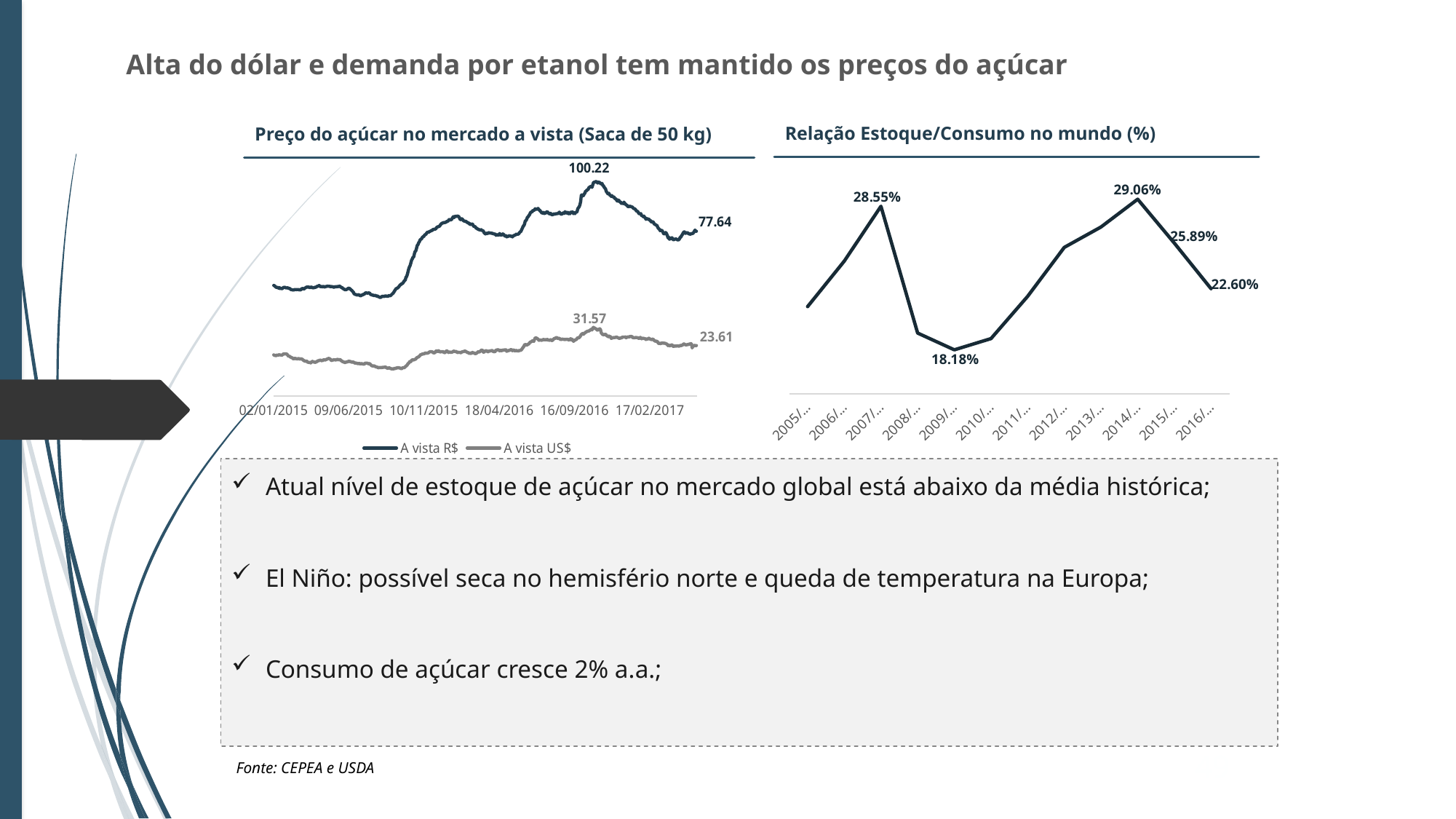
What kind of chart is the left chart, 'Preço do açúcar no mercado a vista (Saca de 50 kg)'? Line chart In the right chart, 'Relação Estoque/Consumo no mundo (%)', what is the lowest labeled value? 18.18% In the left chart, 'Preço do açúcar no mercado a vista', what is the difference between the peak value (100.22) and the final value (77.64) of the 'A vista R$' line? 22.58 In the left chart, 'Preço do açúcar no mercado a vista', what is the final value labeled at the end of the 'A vista US$' line? 23.61 In the right chart, 'Relação Estoque/Consumo no mundo (%)', do the values rise or fall over the last three labeled points (29.06%, 25.89%, 22.60%)? Fall How many seasons (x-axis categories) are shown in the right chart, 'Relação Estoque/Consumo no mundo (%)'? 12 In the left chart, 'Preço do açúcar no mercado a vista', what is the peak value labeled on the 'A vista R$' line? 100.22 In the left chart, 'Preço do açúcar no mercado a vista', what is the peak value labeled on the 'A vista US$' line? 31.57 In the left chart, 'Preço do açúcar no mercado a vista', what is the final value labeled at the end of the 'A vista R$' line? 77.64 What are the two legend entries of the left chart, 'Preço do açúcar no mercado a vista'? A vista R$ and A vista US$ How many series does the legend of the left chart, 'Preço do açúcar no mercado a vista', list? 2 In the right chart, 'Relação Estoque/Consumo no mundo (%)', what is the highest labeled value? 29.06%